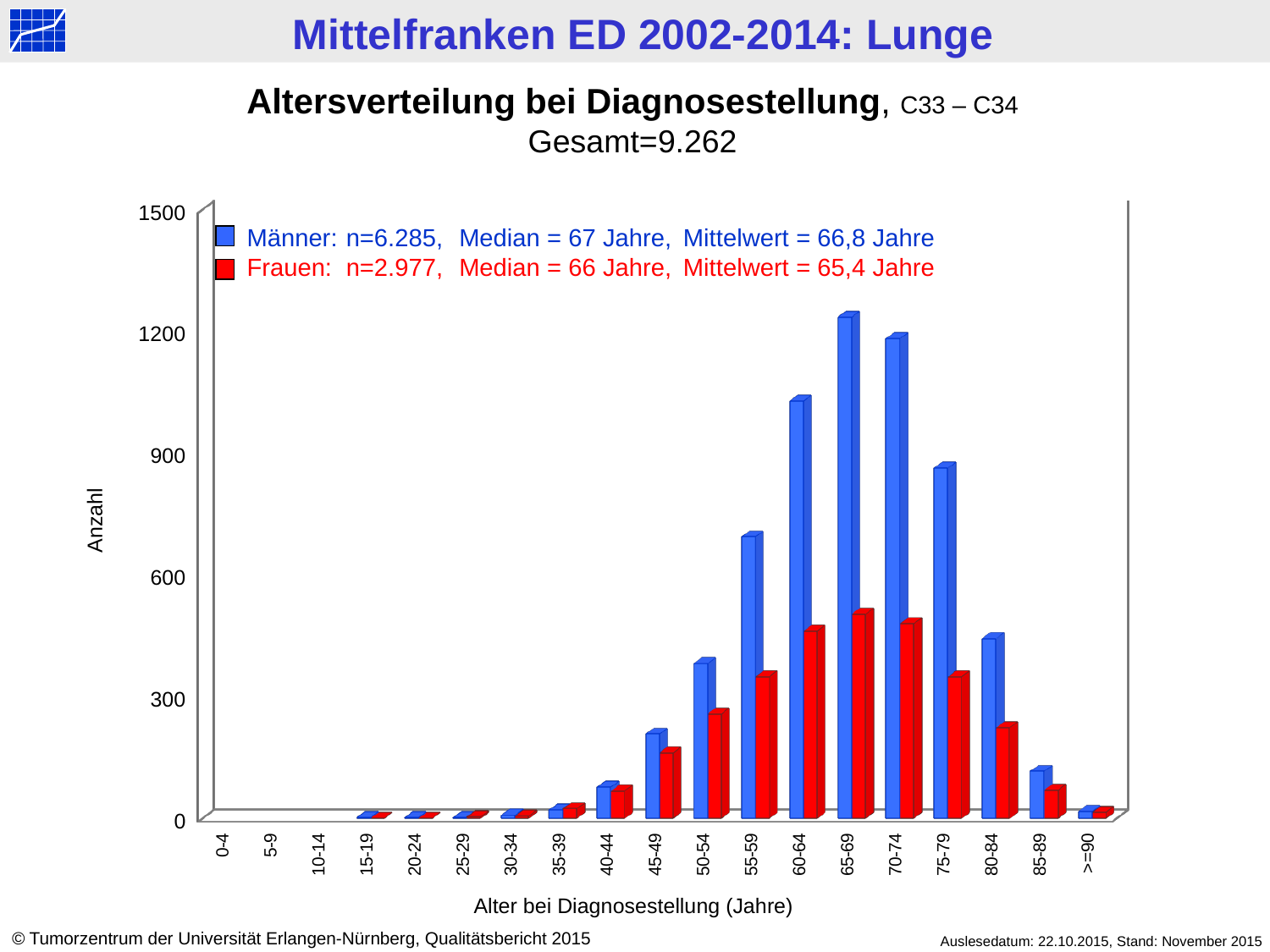
Is the value for Frauen in the 50-54 age group greater or less than 300? less Which age category has the highest value for Männer? 65-69 In the 65-69 age group, which series has the larger value, Männer or Frauen? Männer Do the Männer values rise or fall from the 65-69 age group to the >=90 age group? fall Is the value for Frauen in the 60-64 age group greater or less than 600? less What kind of chart is shown on the slide? bar chart Is the value for Männer in the 60-64 age group greater or less than 900? greater How many age categories are shown on the x axis? 19 How many series does the legend list? 2 According to the legend, what is the median age at diagnosis for Frauen? 66 Jahre For Männer, which is larger: the value for 75-79 or the value for 55-59? 75-79